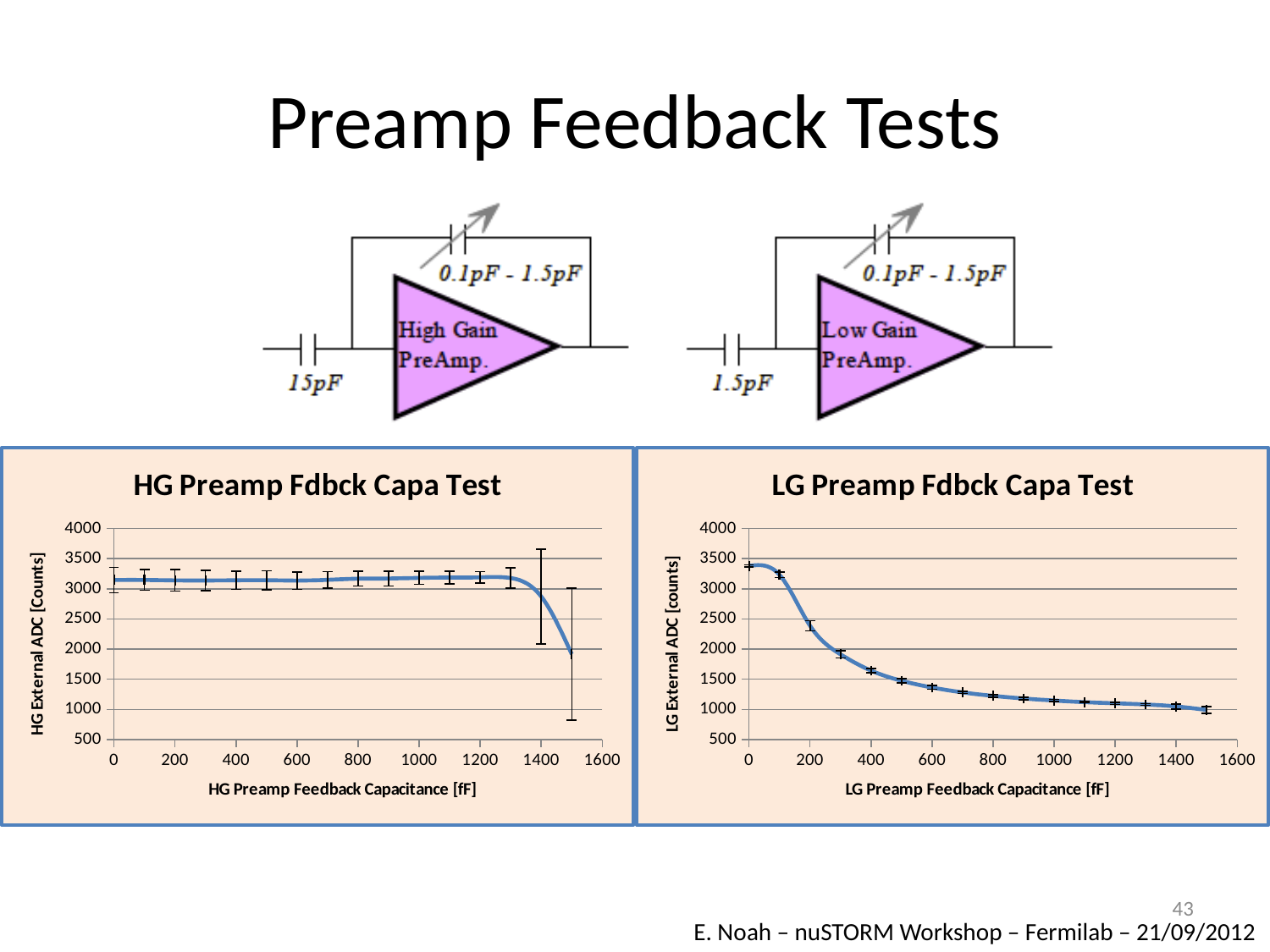
In the LG Preamp Fdbck Capa Test chart, is the value at 0 fF greater or less than 3000? greater What kind of chart is the HG Preamp Fdbck Capa Test chart? line chart In the LG Preamp Fdbck Capa Test chart, at which feedback capacitance is the ADC value lowest? 1500 fF In the HG Preamp Fdbck Capa Test chart, is the value at 0 fF greater or less than 3000? greater In the HG Preamp Fdbck Capa Test chart, is the value at 1500 fF greater or less than 2500? less In the LG Preamp Fdbck Capa Test chart, at which feedback capacitance is the ADC value highest? 0 fF In the LG Preamp Fdbck Capa Test chart, which is larger: the value at 0 fF or the value at 1500 fF? 0 fF In the HG Preamp Fdbck Capa Test chart, at which feedback capacitance is the ADC value lowest? 1500 fF In the LG Preamp Fdbck Capa Test chart, do the values rise or fall as the feedback capacitance increases? fall What is the y-axis label of the LG Preamp Fdbck Capa Test chart? LG External ADC [counts]